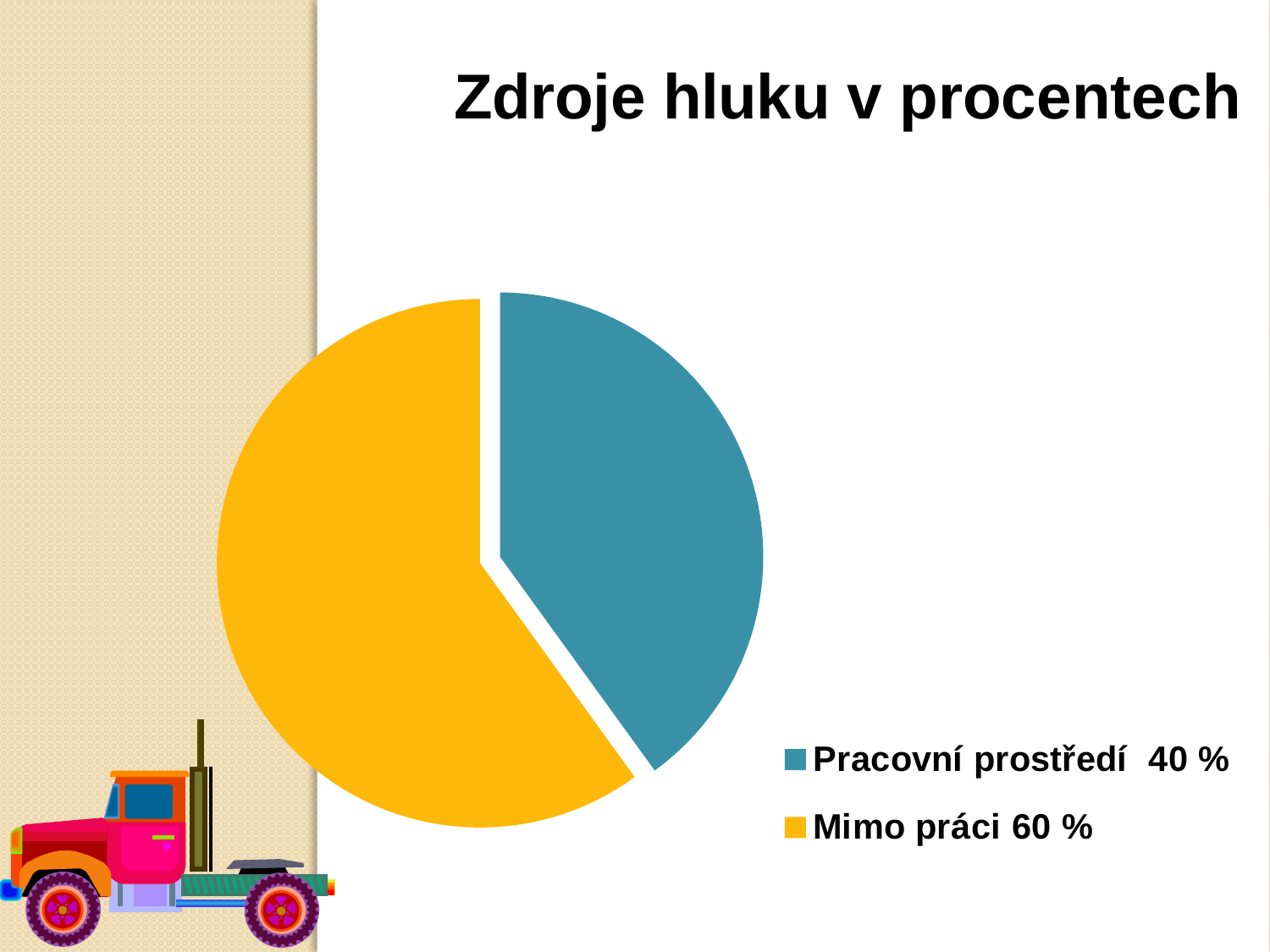
Which slice is the largest? Mimo práci Which slice is the smallest? Pracovní prostředí What is the difference in percentage points between Mimo práci and Pracovní prostředí? 20 % How many slices does the pie chart have? 2 What colour is the Mimo práci slice? yellow What is the total of the two slices? 100 % What share of the pie does Pracovní prostředí represent? 40 % What is the title of the chart? Zdroje hluku v procentech What kind of chart is shown on the slide? pie chart What share of the pie does Mimo práci represent? 60 % Which is larger, Pracovní prostředí or Mimo práci? Mimo práci How many entries does the legend list? 2